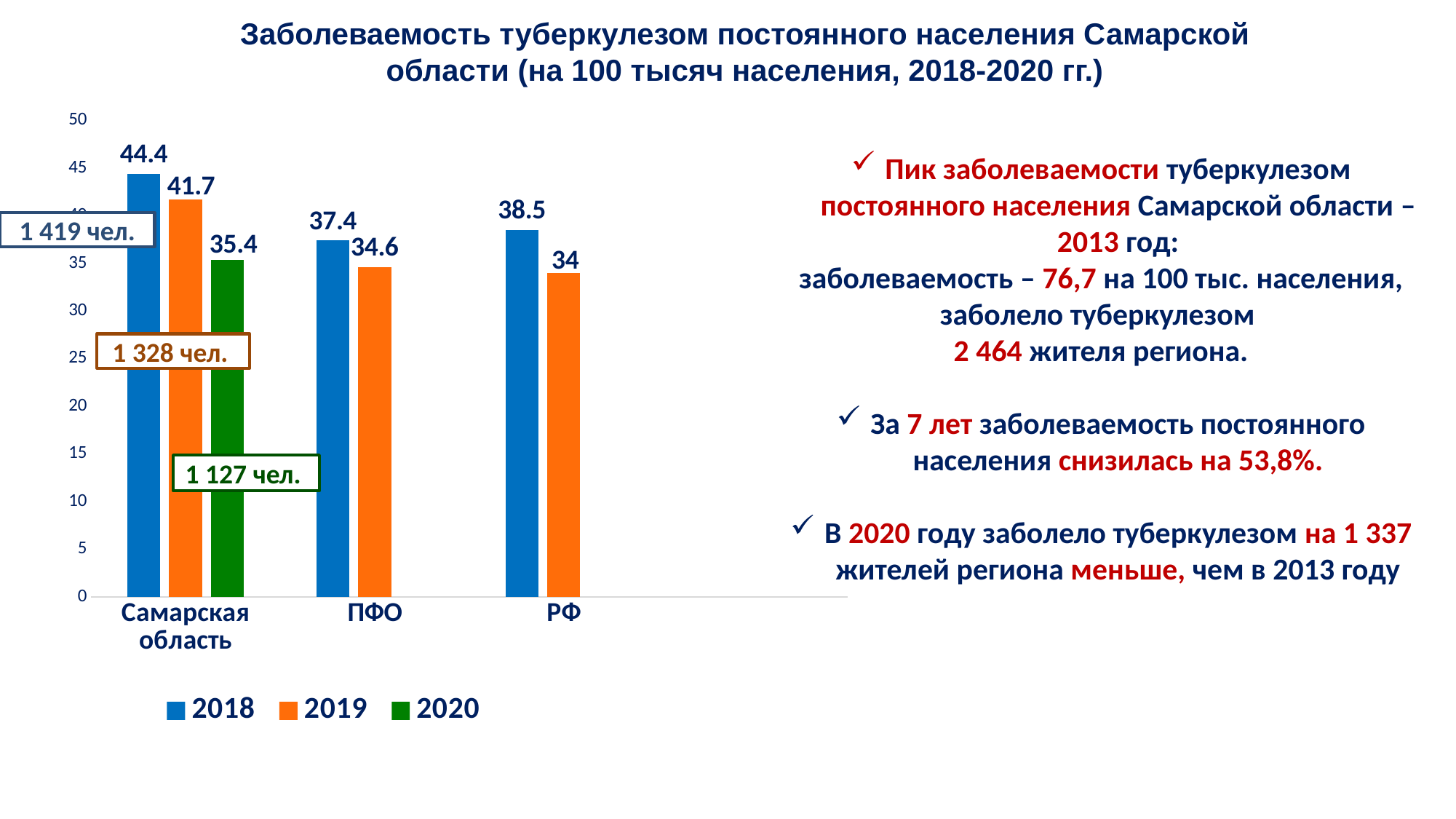
How many categories are shown on the x axis? 3 Which category has the highest 2018 value? Самарская область What is the 2020 value for Самарская область? 35.4 How many series does the legend list? 3 Which is larger: the 2018 value for ПФО or the 2018 value for РФ? РФ Do the values for Самарская область rise or fall from 2018 to 2020? Fall What kind of chart is shown on the slide? Bar chart What is the 2019 value for ПФО? 34.6 What is the difference between the 2018 and 2019 values for Самарская область? 2.7 What is the 2019 value for РФ? 34 Which category has the lowest 2019 value? РФ What is the 2018 value for Самарская область? 44.4